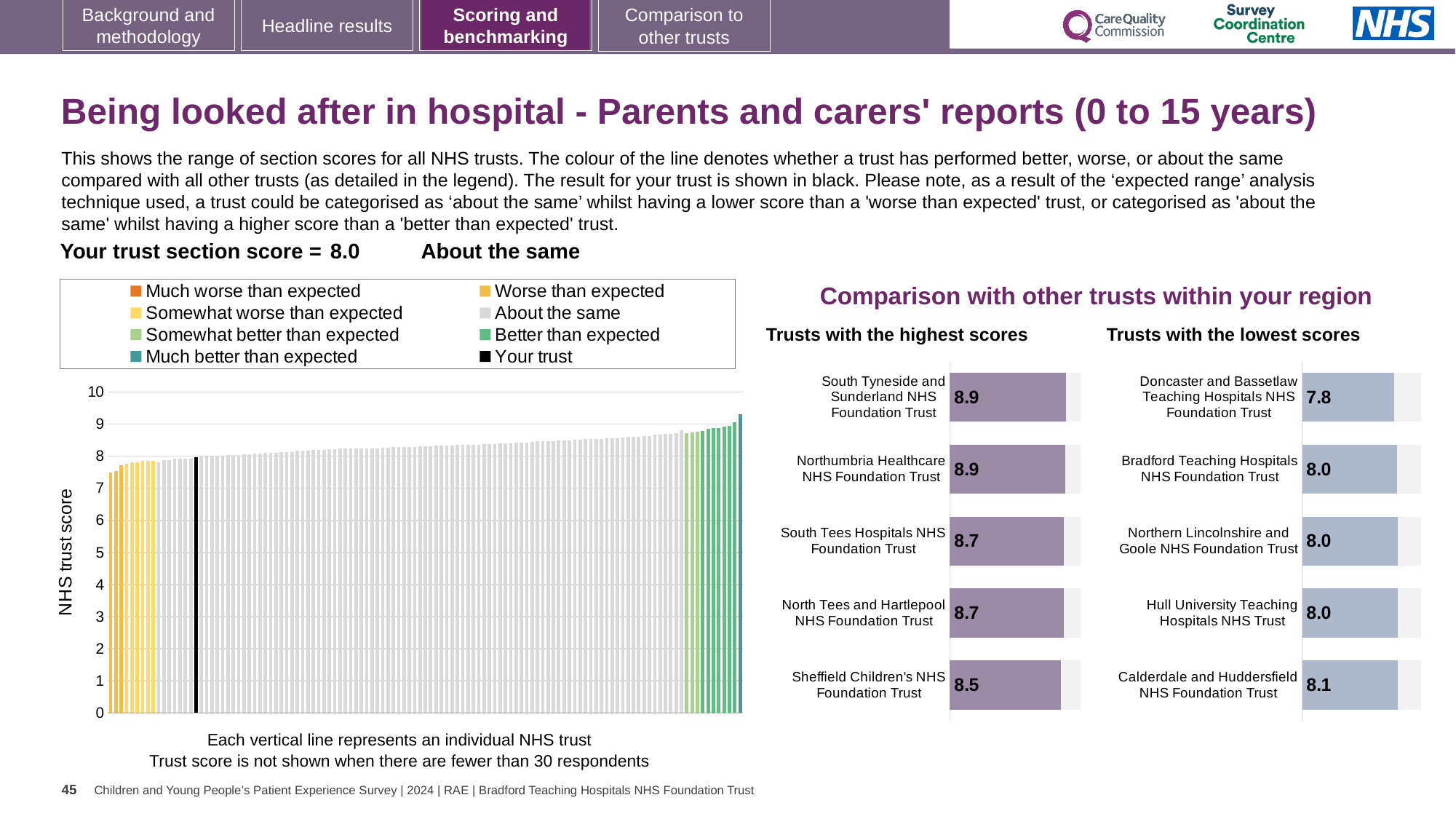
In the 'Trusts with the lowest scores' chart, which is larger: the score for Calderdale and Huddersfield NHS Foundation Trust or the score for Doncaster and Bassetlaw Teaching Hospitals NHS Foundation Trust? Calderdale and Huddersfield NHS Foundation Trust In the main chart on the left, is the value for the black 'Your trust' bar greater or less than 9? less How many trusts are shown in the 'Trusts with the highest scores' chart? 5 In the 'Trusts with the highest scores' chart, which trust has the lowest score? Sheffield Children's NHS Foundation Trust In the 'Trusts with the lowest scores' chart, which trust has the lowest score? Doncaster and Bassetlaw Teaching Hospitals NHS Foundation Trust In the 'Trusts with the lowest scores' chart, what is the score for Calderdale and Huddersfield NHS Foundation Trust? 8.1 In the main chart on the left, do the trust scores rise or fall from left to right? rise In the 'Trusts with the highest scores' chart, what is the difference between the score for South Tyneside and Sunderland NHS Foundation Trust and the score for Sheffield Children's NHS Foundation Trust? 0.4 In the 'Trusts with the lowest scores' chart, what is the score for Doncaster and Bassetlaw Teaching Hospitals NHS Foundation Trust? 7.8 What is the section score for your trust shown on the slide? 8.0 In the 'Trusts with the highest scores' chart, what is the score for Sheffield Children's NHS Foundation Trust? 8.5 What kind of chart is the main chart on the left showing all NHS trusts? bar chart